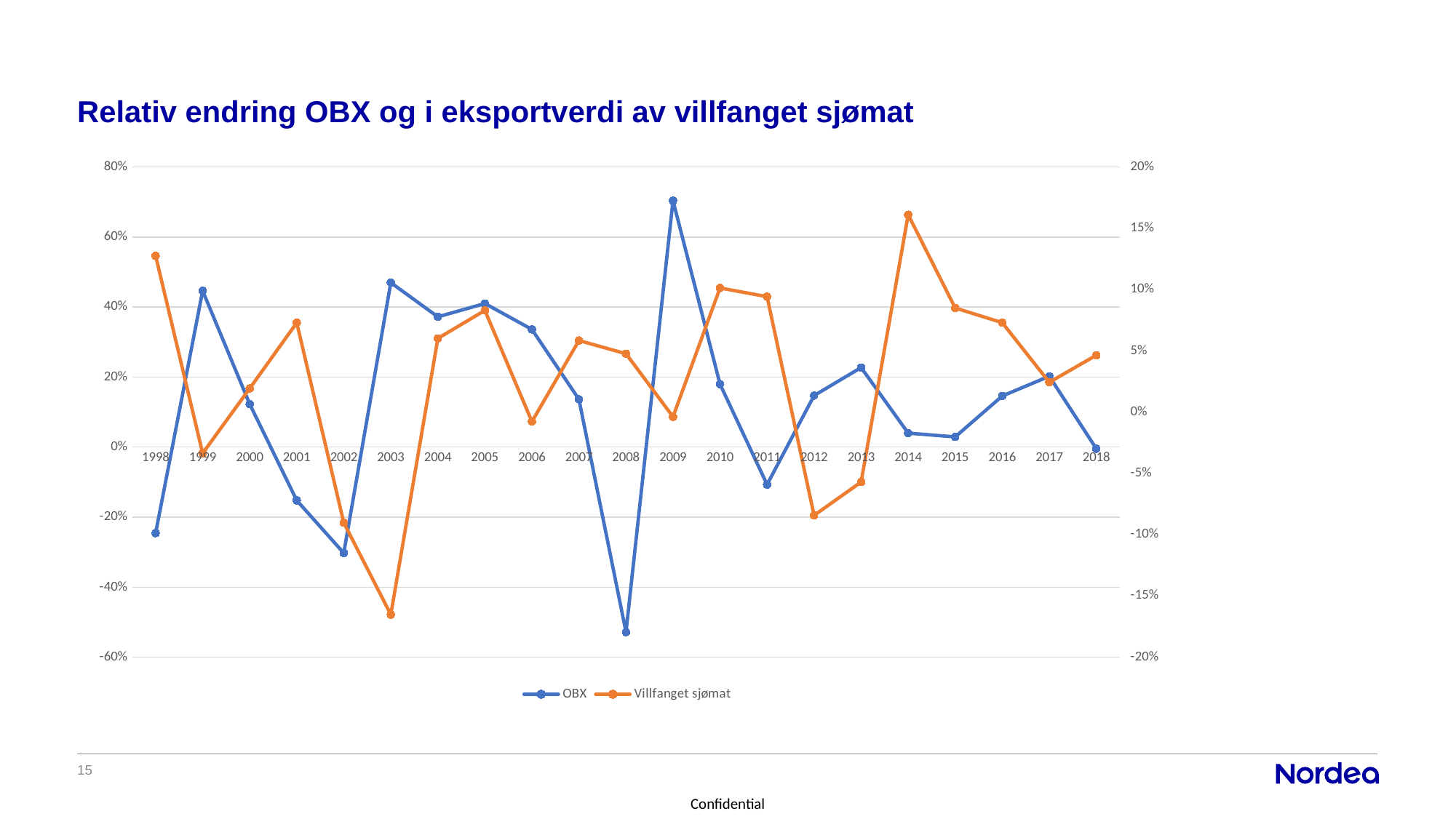
How many series does the legend list? 2 Is the OBX value for 2008 greater or less than -40% on the left axis? less In which year does the Villfanget sjømat series reach its lowest value? 2003 In which year does the OBX series reach its highest value? 2009 Is the OBX value for 2009 greater or less than 60% on the left axis? greater Does the OBX series rise or fall from 2009 to 2011? fall In which year does the OBX series reach its lowest value? 2008 Is the Villfanget sjømat value for 2012 greater or less than -5% on the right axis? less Which is larger, the OBX value for 1999 or the OBX value for 2000? 1999 How many years are plotted along the x axis? 21 What kind of chart is shown on the slide? line chart In which year does the Villfanget sjømat series reach its highest value? 2014